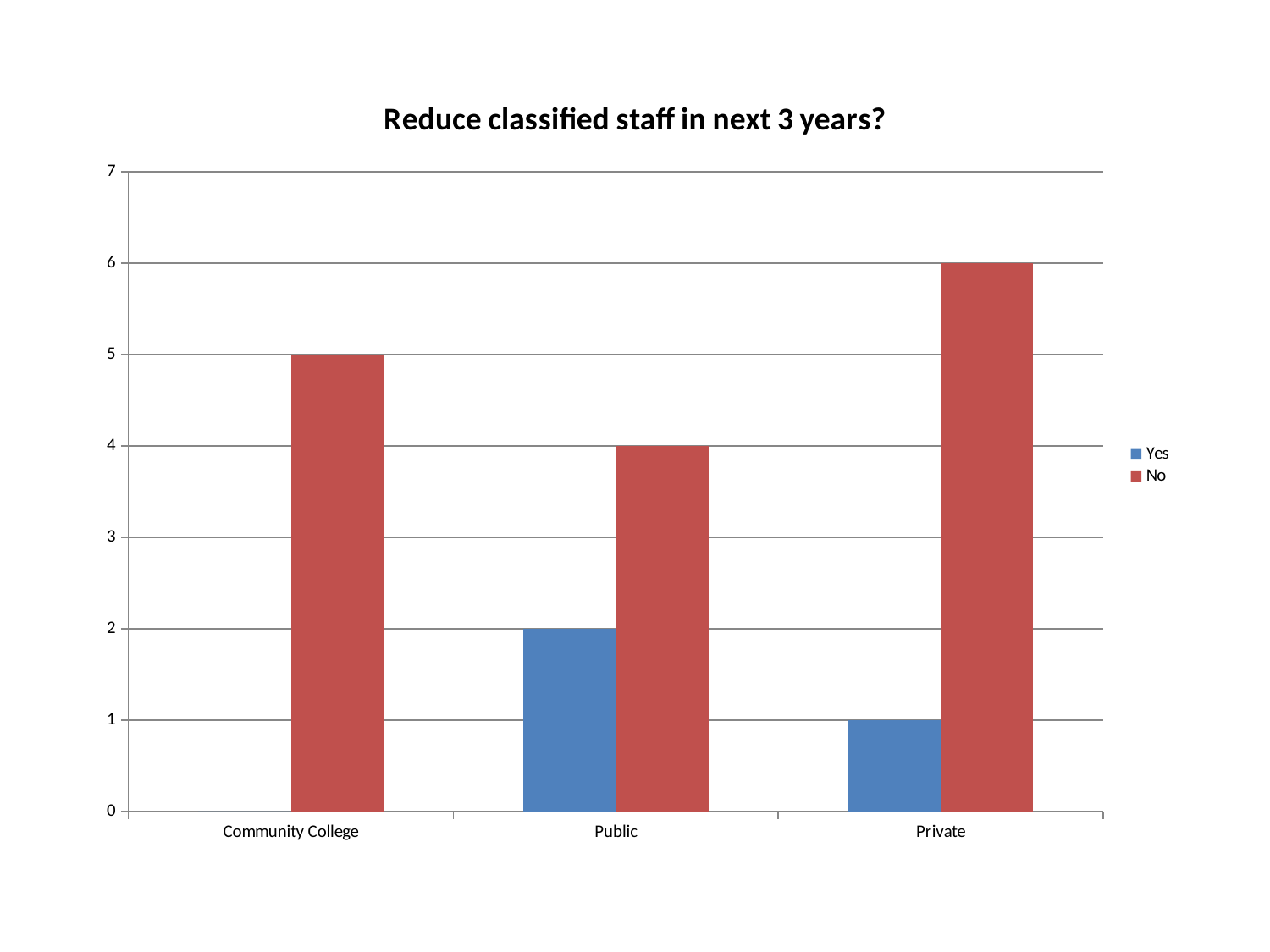
How many series does the legend list? 2 What is the value of No for Public? 4 Which is larger for Private, Yes or No? No How many categories are shown on the x axis? 3 What is the difference between No and Yes for Public? 2 What is the value of No for Private? 6 What type of chart is shown on the slide? bar chart What is the title of the chart? Reduce classified staff in next 3 years? What is the value of No for Community College? 5 Which category has the highest No value? Private What is the value of Yes for Private? 1 What is the value of Yes for Public? 2